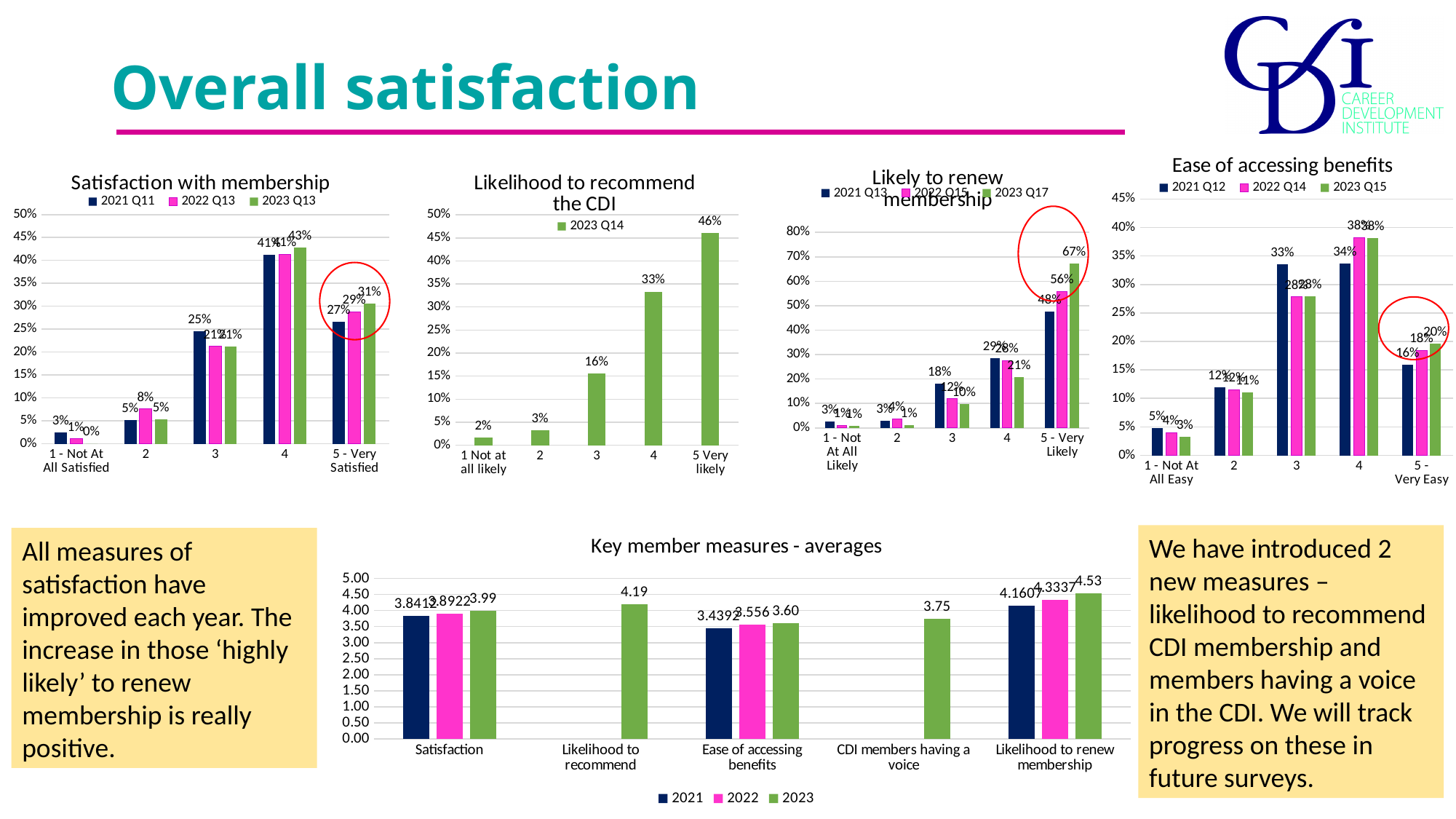
In the 'Satisfaction with membership' chart, which is larger for '5 - Very Satisfied': the 2021 Q11 value or the 2023 Q13 value? 2023 Q13 How many categories are shown on the x axis of the 'Key member measures - averages' chart? 5 In the 'Ease of accessing benefits' chart, which category has the lowest 2021 Q12 value? 1 - Not At All Easy In the 'Likelihood to recommend the CDI' chart, what is the value for '5 Very likely'? 46% In the 'Likelihood to recommend the CDI' chart, do the values rise or fall from '1 Not at all likely' to '5 Very likely'? Rise In the 'Likely to renew membership' chart, what is the difference between the 2023 Q17 and 2021 Q13 values for '5 - Very Likely'? 19% In the 'Satisfaction with membership' chart, which category has the highest 2023 Q13 value? 4 In the 'Key member measures - averages' chart, what is the 2023 value for 'Likelihood to renew membership'? 4.53 How many series does the legend of the 'Ease of accessing benefits' chart list? 3 In the 'Likely to renew membership' chart, what is the 2023 Q17 value for '5 - Very Likely'? 67% What kind of chart is the 'Likelihood to recommend the CDI' chart? Bar chart In the 'Key member measures - averages' chart, what is the value for 'CDI members having a voice'? 3.75